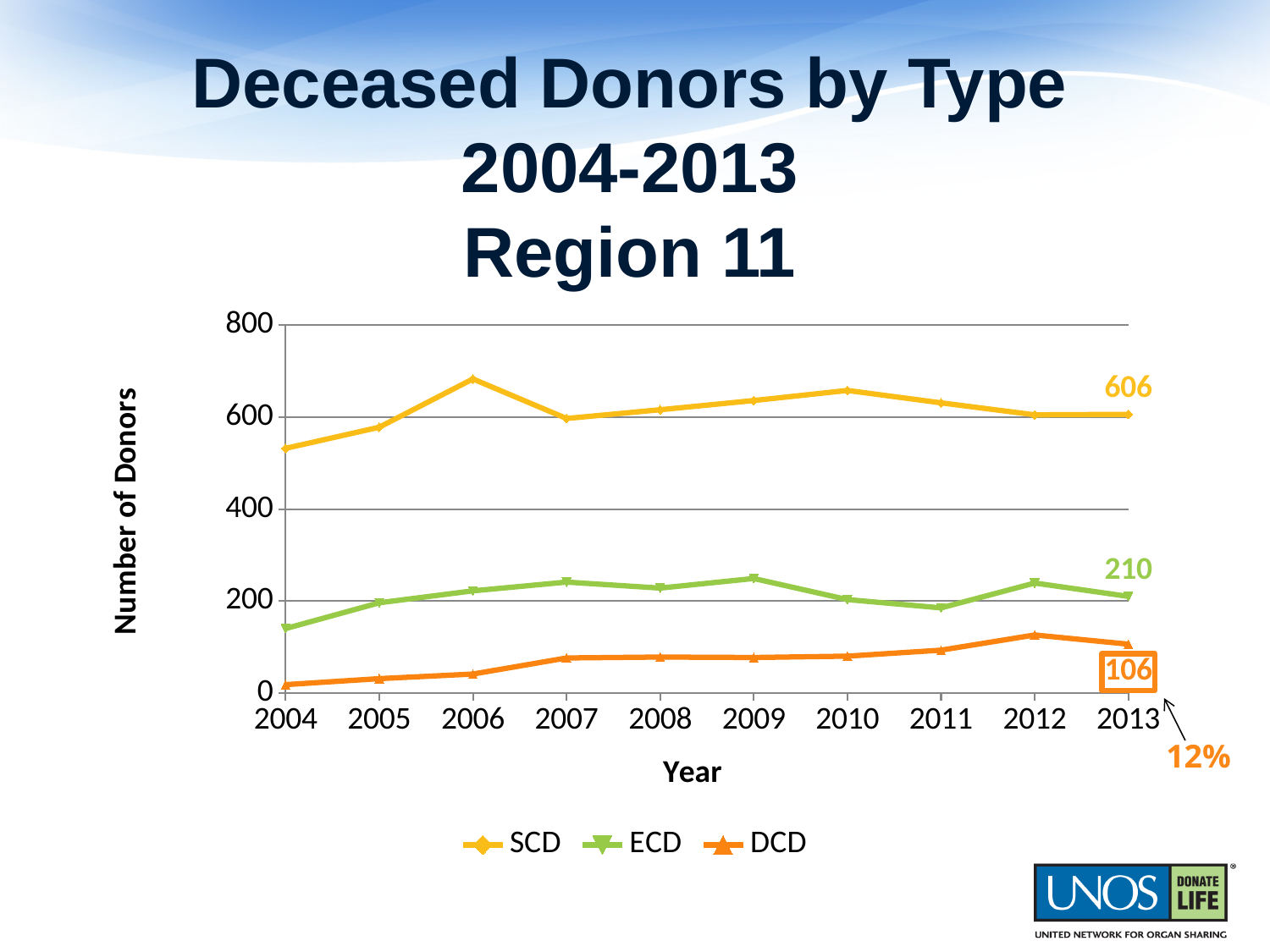
How many series does the legend list? 3 What is the value for ECD in 2013? 210 Is the value for DCD in 2004 greater or less than 100? less Which series has the highest value in 2013? SCD How many years are shown on the x axis? 10 What is the difference between the ECD and DCD values in 2013? 104 What is the difference between the SCD and ECD values in 2013? 396 What is the value for DCD in 2013? 106 Which series has the lowest value in 2013? DCD Is the value for SCD in 2006 greater or less than 600? greater What kind of chart is shown on the slide? line chart What is the value for SCD in 2013? 606